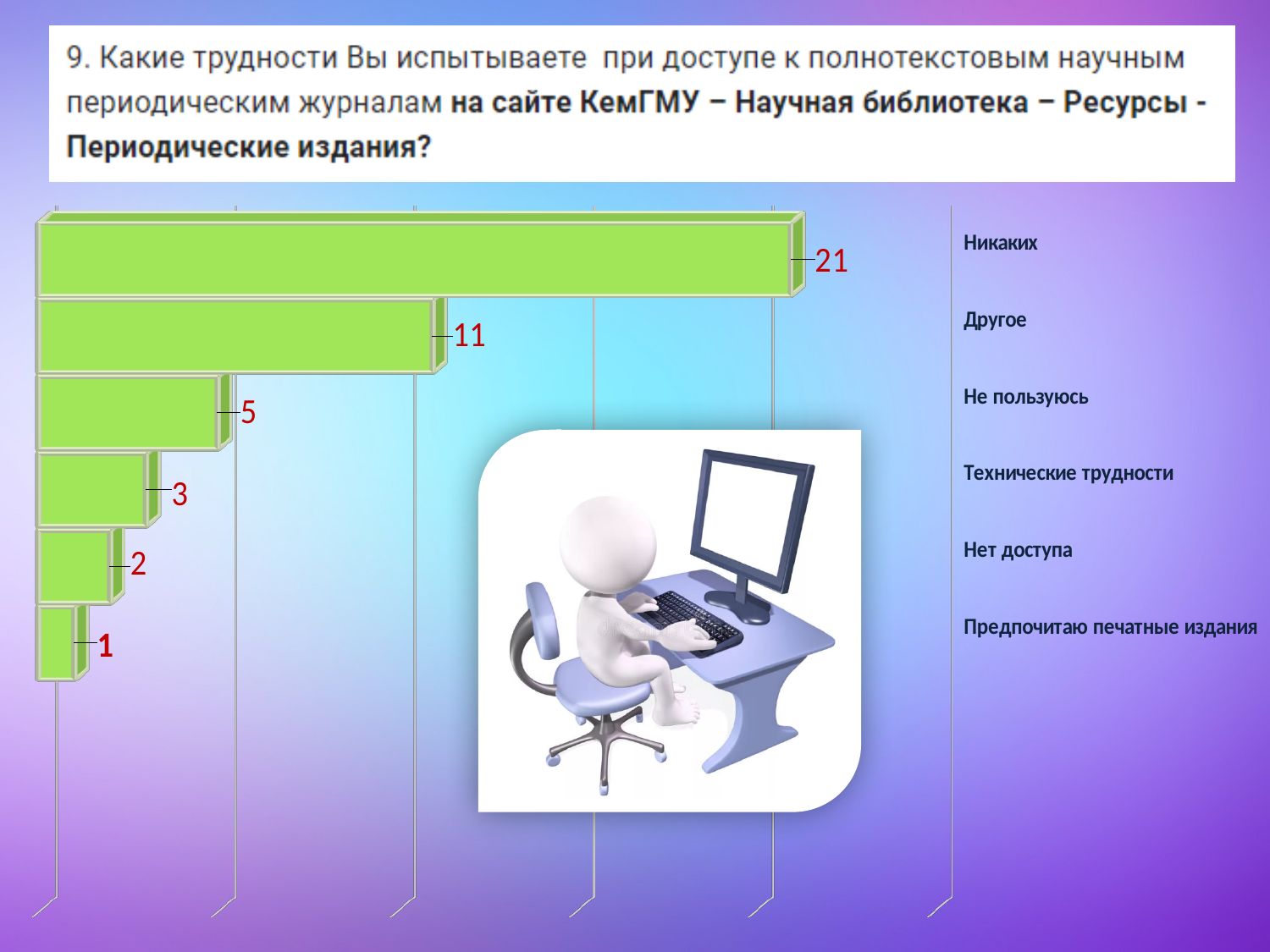
What value is shown for "Другое"? 11 Which category has the highest value? Никаких What value is shown for "Предпочитаю печатные издания"? 1 What value is shown for "Технические трудности"? 3 What is the difference between the values for "Технические трудности" and "Нет доступа"? 1 What kind of chart is shown on the slide? Bar chart How many categories are shown in the chart? 6 Which is larger, the value for "Не пользуюсь" or the value for "Нет доступа"? Не пользуюсь What value is shown for "Не пользуюсь"? 5 What is the difference between the values for "Никаких" and "Другое"? 10 Which category has the lowest value? Предпочитаю печатные издания What value is shown for "Никаких"? 21